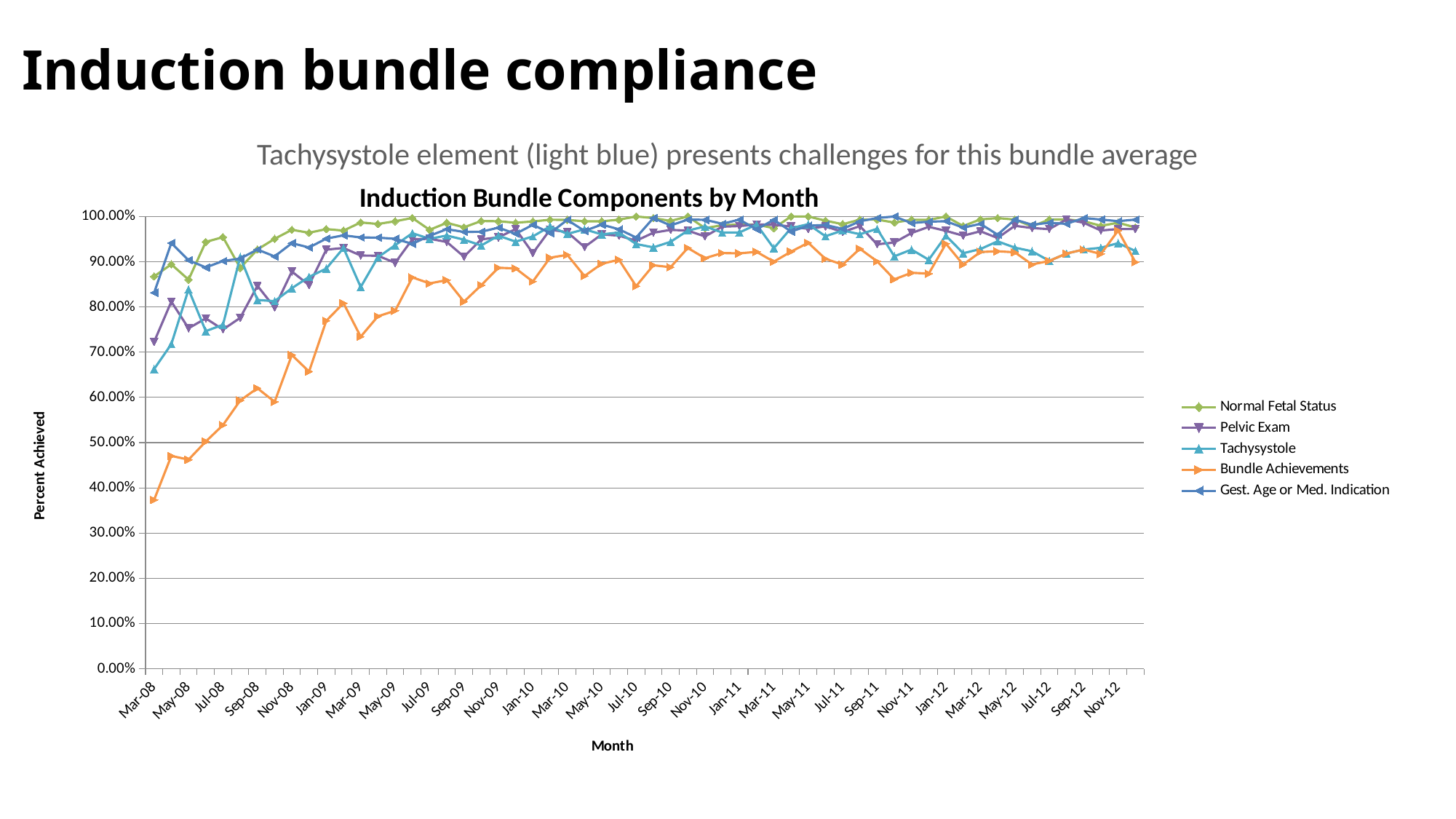
Does the Bundle Achievements series generally rise or fall from Mar-08 to Nov-12? Rise At Mar-08, which is larger: Pelvic Exam or Tachysystole? Pelvic Exam How many series does the legend list? 5 Is the value for Tachysystole at Mar-08 greater or less than 60.00%? greater What kind of chart is shown on the slide? Line chart At Mar-08, which is larger: Normal Fetal Status or Bundle Achievements? Normal Fetal Status Is the value for Bundle Achievements at May-08 greater or less than 50.00%? less What is the title of the chart? Induction Bundle Components by Month Which series has the lowest value at Mar-08? Bundle Achievements Is the value for Bundle Achievements at Mar-08 greater or less than 40.00%? less Which series is shown in orange in the legend? Bundle Achievements Which series has the highest value at Mar-08? Normal Fetal Status